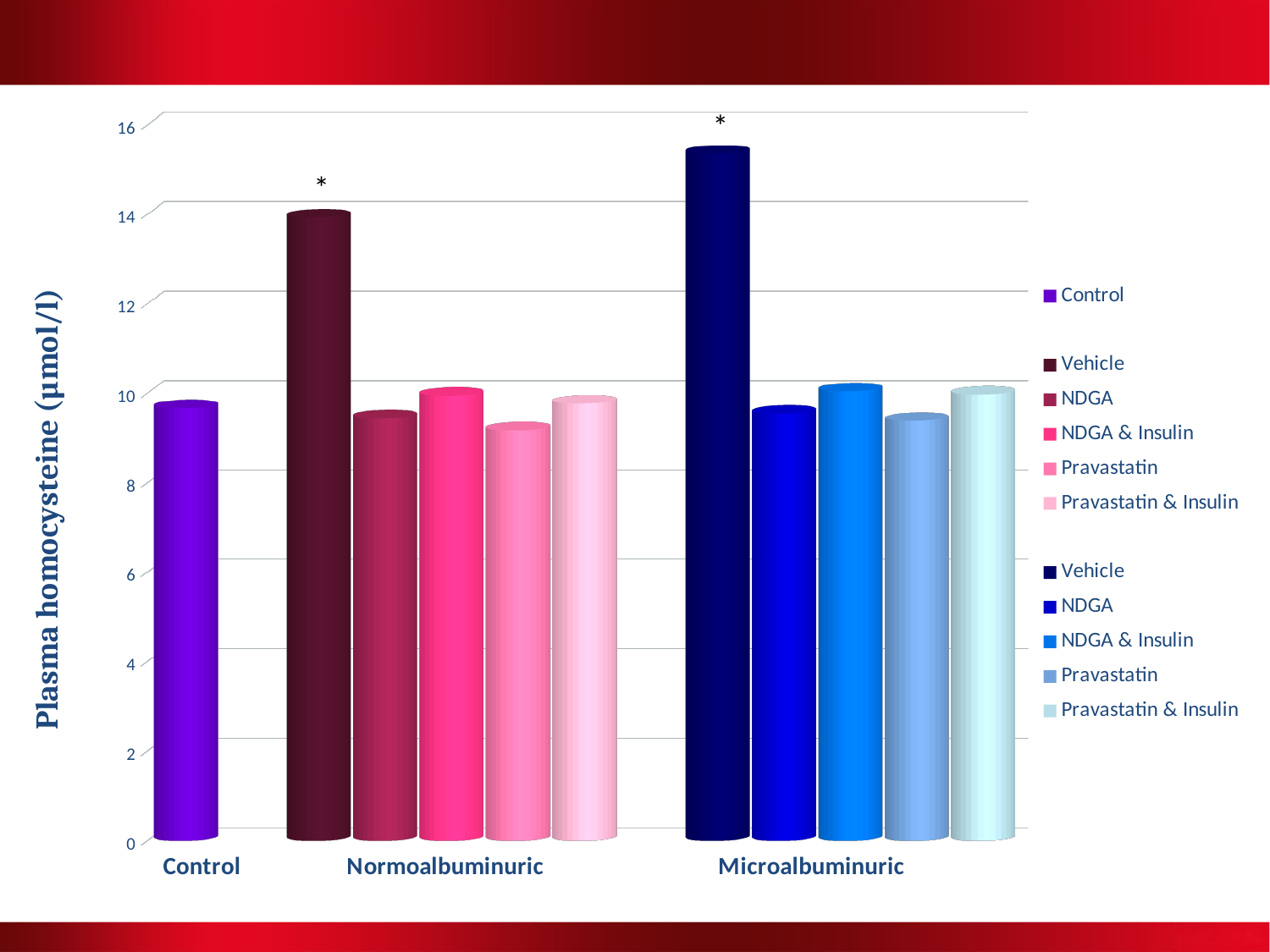
Which is larger: Vehicle in the Normoalbuminuric group or Vehicle in the Microalbuminuric group? Vehicle in the Microalbuminuric group Is the value for Pravastatin in the Normoalbuminuric group greater or less than 10? less Is the value for Pravastatin in the Microalbuminuric group greater or less than 10? less Is the value for Vehicle in the Microalbuminuric group greater or less than 14? greater What kind of chart is shown on the slide? bar chart How many category groups are labelled along the x axis? 3 What is the label of the y axis? Plasma homocysteine (µmol/l) How many entries does the legend list? 11 Which bar is the tallest in the chart? Vehicle in the Microalbuminuric group Which bars are marked with an asterisk? The Vehicle bars in the Normoalbuminuric and Microalbuminuric groups Which is larger in the Normoalbuminuric group: Vehicle or NDGA? Vehicle